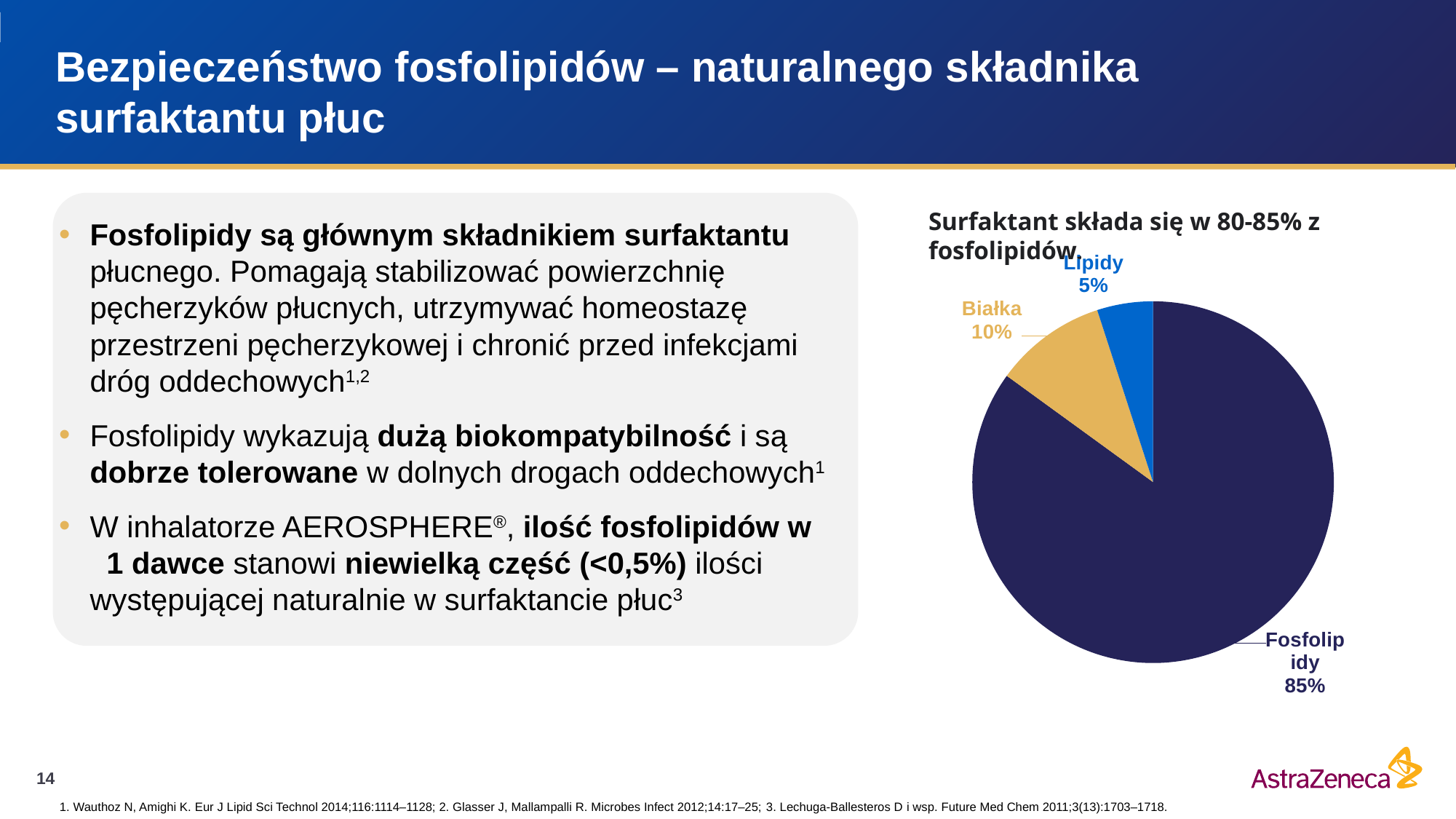
What is the difference in percentage points between the Białka slice and the Lipidy slice? 5 How many slices does the pie chart have? 3 Which is larger, the Białka slice or the Lipidy slice? Białka What share of the pie does Lipidy represent? 5% What share of the pie does Białka represent? 10% Which slice of the pie chart is the smallest? Lipidy What is the difference in percentage points between the Fosfolipidy slice and the Białka slice? 75 What share of the pie does Fosfolipidy represent? 85% What kind of chart is shown on the slide? pie chart What is the title of the pie chart? Surfaktant składa się w 80-85% z fosfolipidów Which slice of the pie chart is the largest? Fosfolipidy What colour is the Białka slice of the pie chart? gold